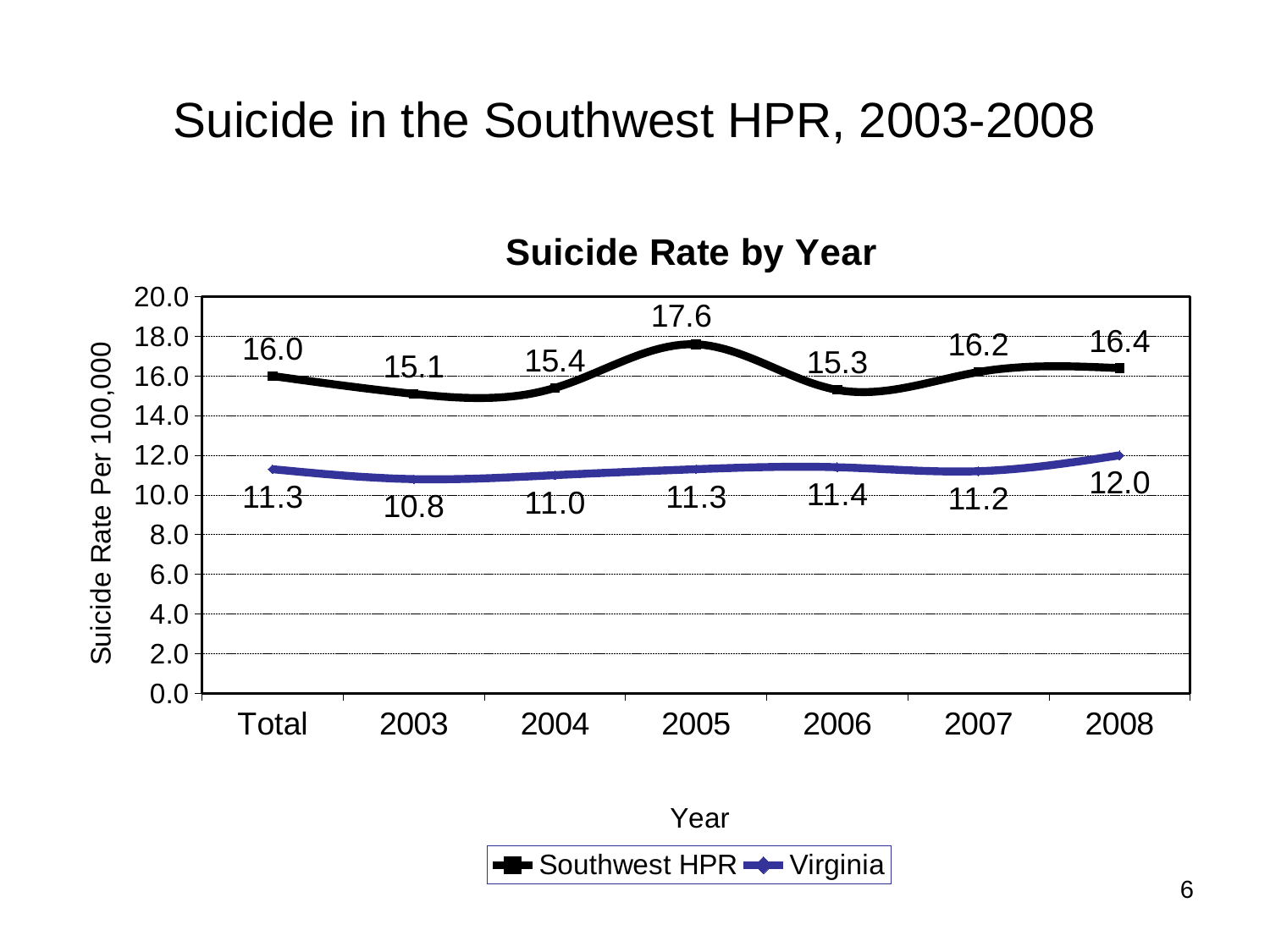
What kind of chart is shown? Line chart What is the Virginia suicide rate in 2003? 10.8 What is the difference between the Southwest HPR and Virginia rates in 2008? 4.4 What is the y-axis label of the chart? Suicide Rate Per 100,000 In which year is the Southwest HPR suicide rate highest? 2005 What is the Southwest HPR value for Total? 16.0 Is the Southwest HPR value for 2007 greater or less than 14.0? greater How many series does the legend list? 2 Which series has the higher value in 2006, Southwest HPR or Virginia? Southwest HPR What is the Southwest HPR suicide rate in 2005? 17.6 How many categories are shown on the x axis? 7 In which year is the Virginia suicide rate lowest? 2003